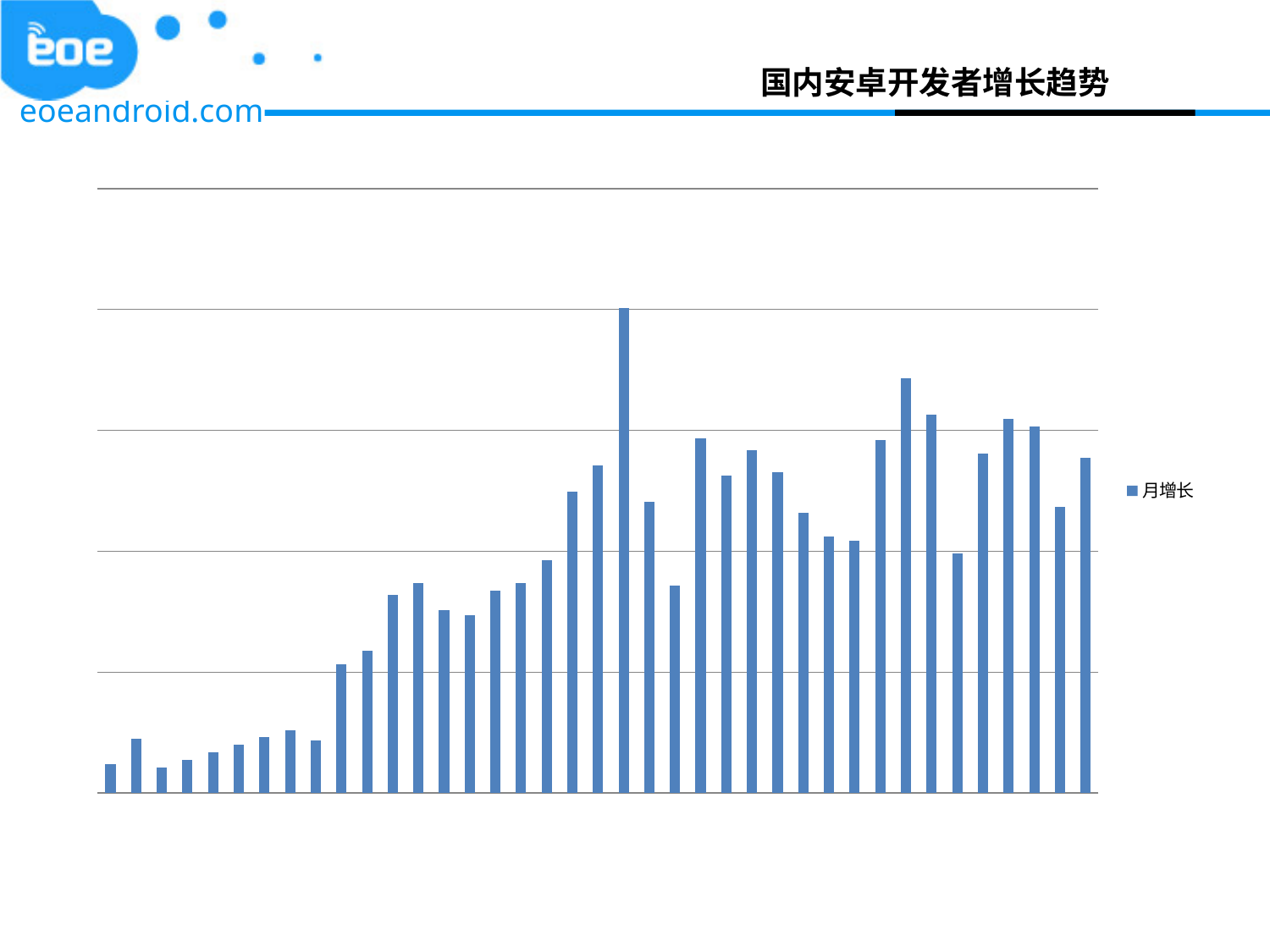
How many bars are plotted in the chart? 39 What is the title shown above the chart on the slide? 国内安卓开发者增长趋势 What is the name of the series shown in the legend? 月增长 Which is taller, the first bar or the last bar? the last bar Is the tallest bar located at the far right end of the chart? No How many series does the legend list? 1 Do the values generally rise or fall from left to right along the x axis? rise What kind of chart is shown on the slide? bar chart